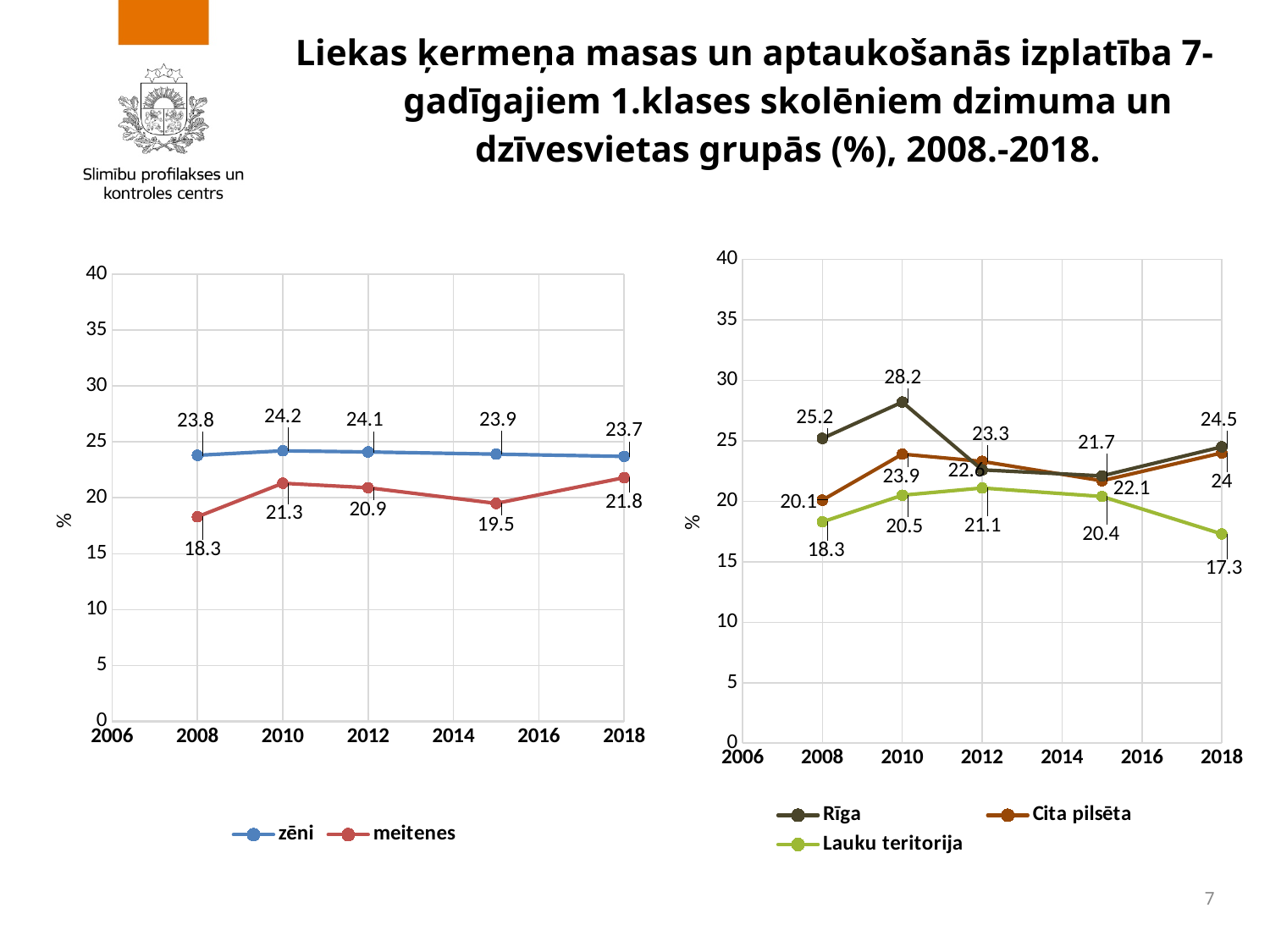
In the left chart, what is the value for meitenes in 2015? 19.5 In the right chart, what is the difference between Rīga and Lauku teritorija in 2008? 6.9 What type of chart is the right chart? line chart In the left chart, what is the difference between zēni and meitenes in 2008? 5.5 In the right chart, in which year is the value for Rīga highest? 2010 In the right chart, what is the value for Lauku teritorija in 2018? 17.3 How many series does the legend of the left chart list? 2 How many series does the legend of the right chart list? 3 In the right chart, what is the value for Rīga in 2010? 28.2 In the left chart, what is the value for zēni in 2010? 24.2 In the left chart, in which year is the value for meitenes lowest? 2008 In the left chart, which series has the higher value in 2018, zēni or meitenes? zēni